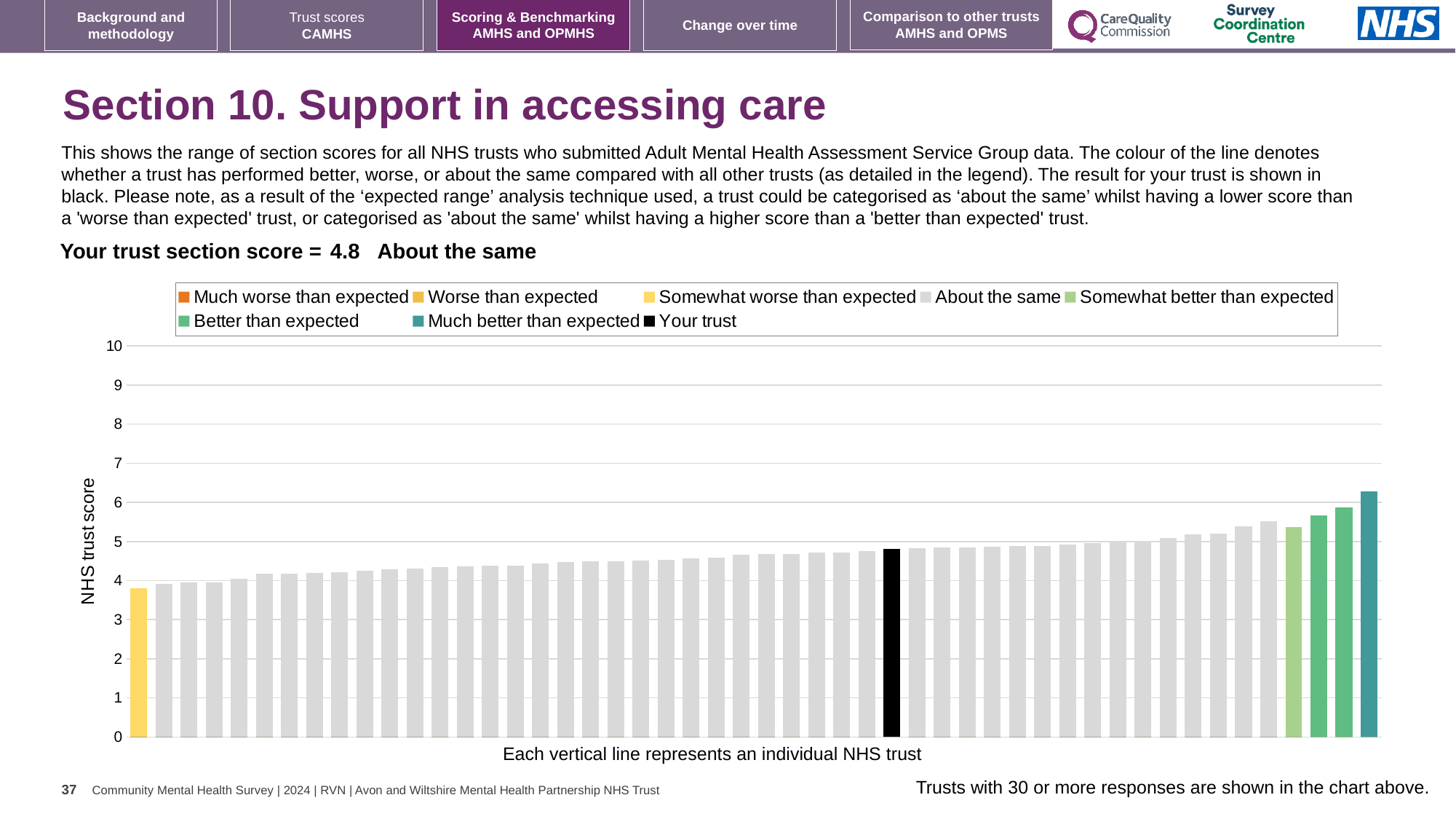
What colour is the bar representing your trust? black What is the section score for your trust, as printed on the slide? 4.8 Do the bar values rise or fall from left to right along the x axis? rise Which legend category does the shortest bar in the chart belong to? Somewhat worse than expected How many bars in the chart are coloured teal (Much better than expected)? 1 What kind of chart is shown on the slide? bar chart Is the value of the leftmost yellow bar greater or less than 5? less How many entries does the chart legend list? 8 Is the value of the black 'Your trust' bar greater or less than 4? greater Is the value of the tallest bar (the rightmost, teal bar) greater or less than 6? greater What is the label on the vertical axis of the chart? NHS trust score Which legend category does the tallest bar in the chart belong to? Much better than expected